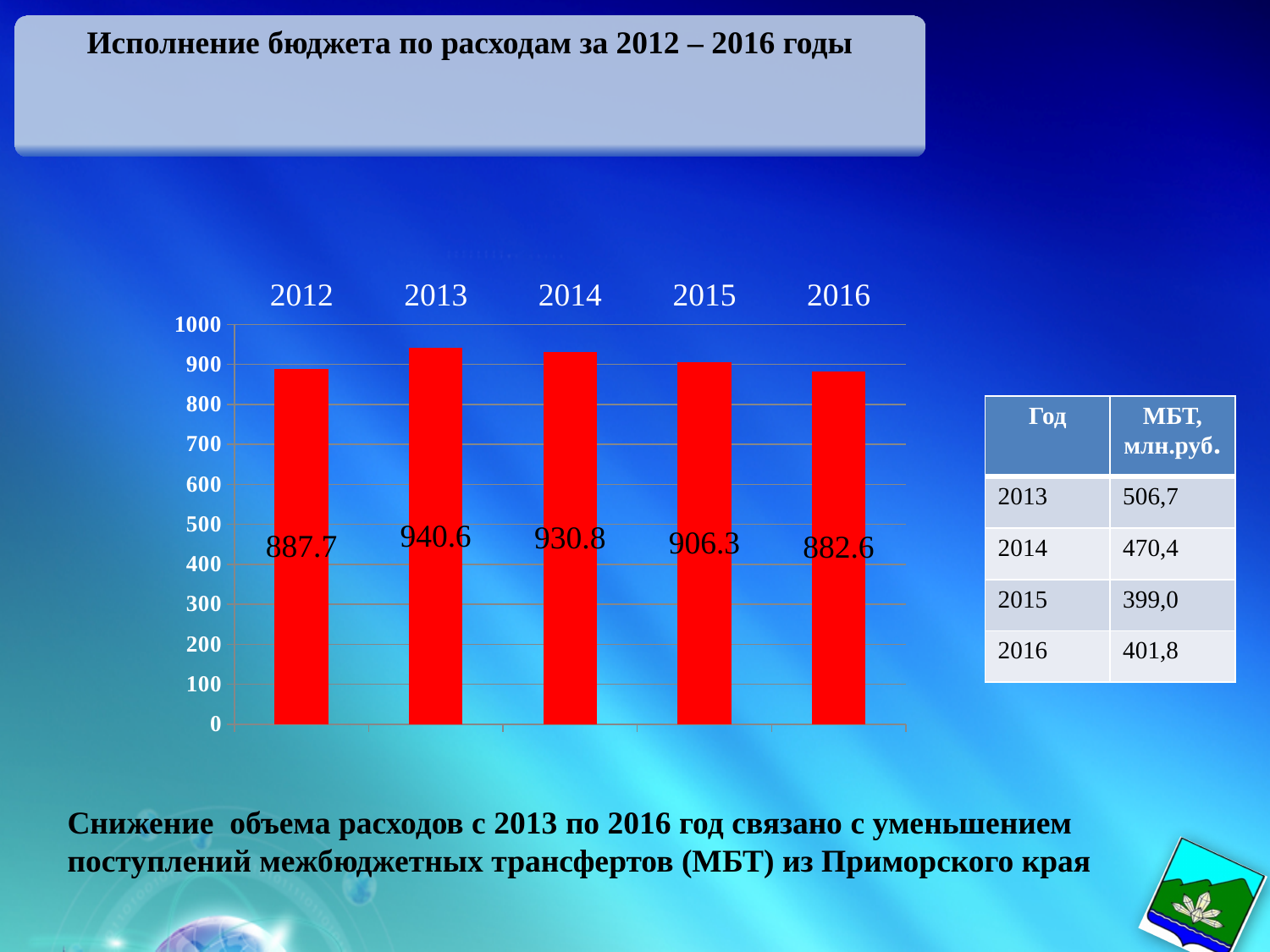
Is the value for 2015 greater or less than 900? greater What is the difference between the values for 2013 and 2016? 58.0 Which is larger, the value for 2014 or the value for 2015? 2014 Do the values rise or fall from 2013 to 2016? fall How many years are shown on the bar chart? 5 What is the value for 2014 on the bar chart? 930.8 What is the difference between the values for 2013 and 2012? 52.9 Which year has the highest bar on the chart? 2013 Which year has the lowest bar on the chart? 2016 What kind of chart is shown on the slide? bar chart What is the value for 2012 on the bar chart? 887.7 What is the value for 2016 on the bar chart? 882.6